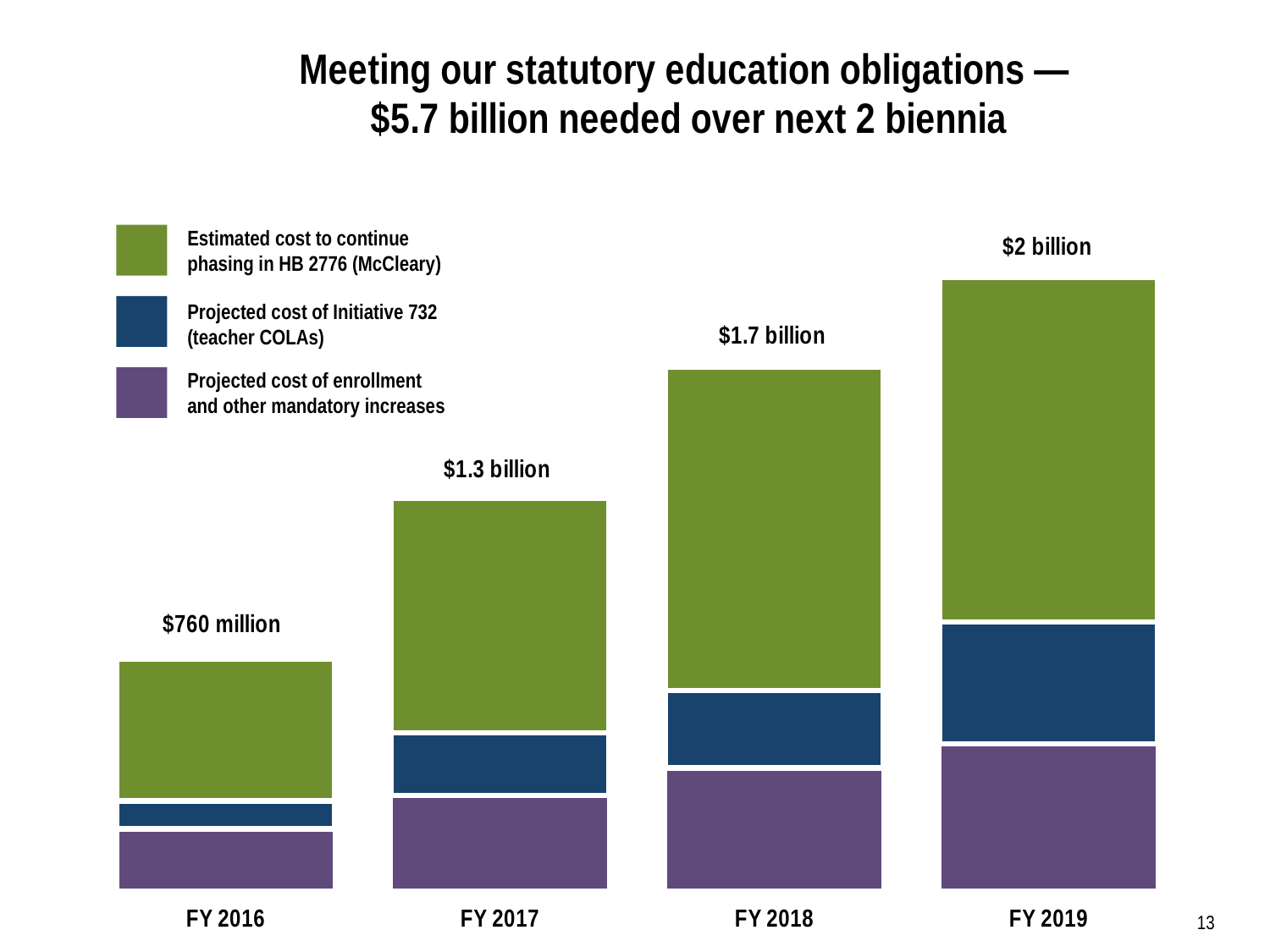
How many fiscal years are shown on the chart? 4 What is the total labeled for FY 2019? $2 billion Do the total costs rise or fall from FY 2016 to FY 2019? Rise What is the total labeled for FY 2016? $760 million Which fiscal year has the highest total cost? FY 2019 Which is larger, the total for FY 2017 or the total for FY 2018? FY 2018 What is the total labeled for FY 2018? $1.7 billion What is the total labeled for FY 2017? $1.3 billion What is the difference between the FY 2018 total and the FY 2017 total? $0.4 billion What kind of chart is shown on the slide? Stacked bar chart How many series does the legend list? 3 Which fiscal year has the lowest total cost? FY 2016